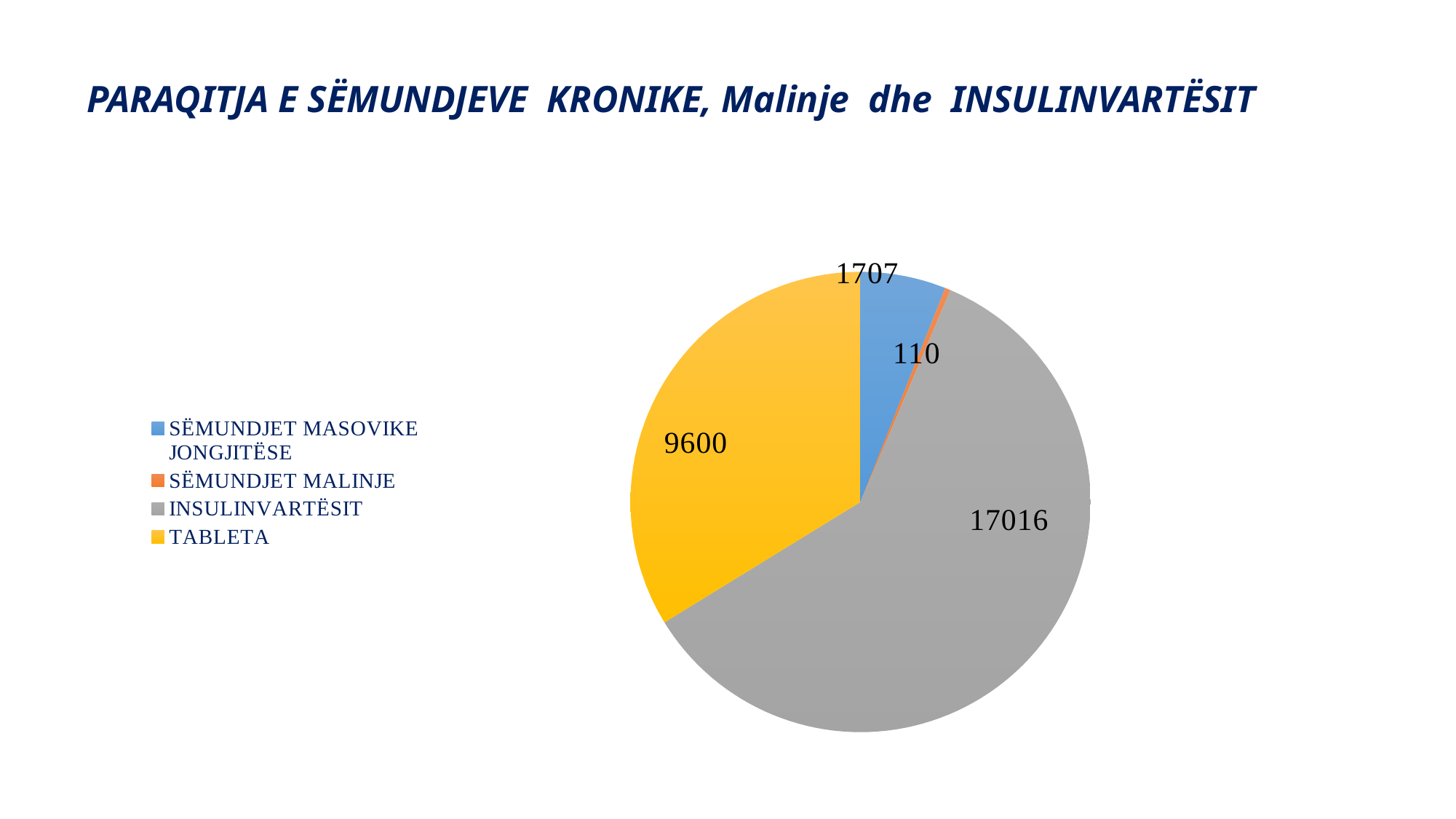
What is the difference between the values for SËMUNDJET MASOVIKE JONGJITËSE and SËMUNDJET MALINJE? 1597 What is the value for INSULINVARTËSIT? 17016 What colour is the slice for TABLETA? yellow How many categories does the legend list? 4 What is the value for SËMUNDJET MALINJE? 110 What is the difference between the values for INSULINVARTËSIT and TABLETA? 7416 Which is larger, the value for TABLETA or the value for SËMUNDJET MASOVIKE JONGJITËSE? TABLETA What is the value for SËMUNDJET MASOVIKE JONGJITËSE? 1707 What type of chart is shown on the slide? pie chart Which category has the largest slice of the pie? INSULINVARTËSIT Which category has the smallest slice of the pie? SËMUNDJET MALINJE What is the value for TABLETA? 9600